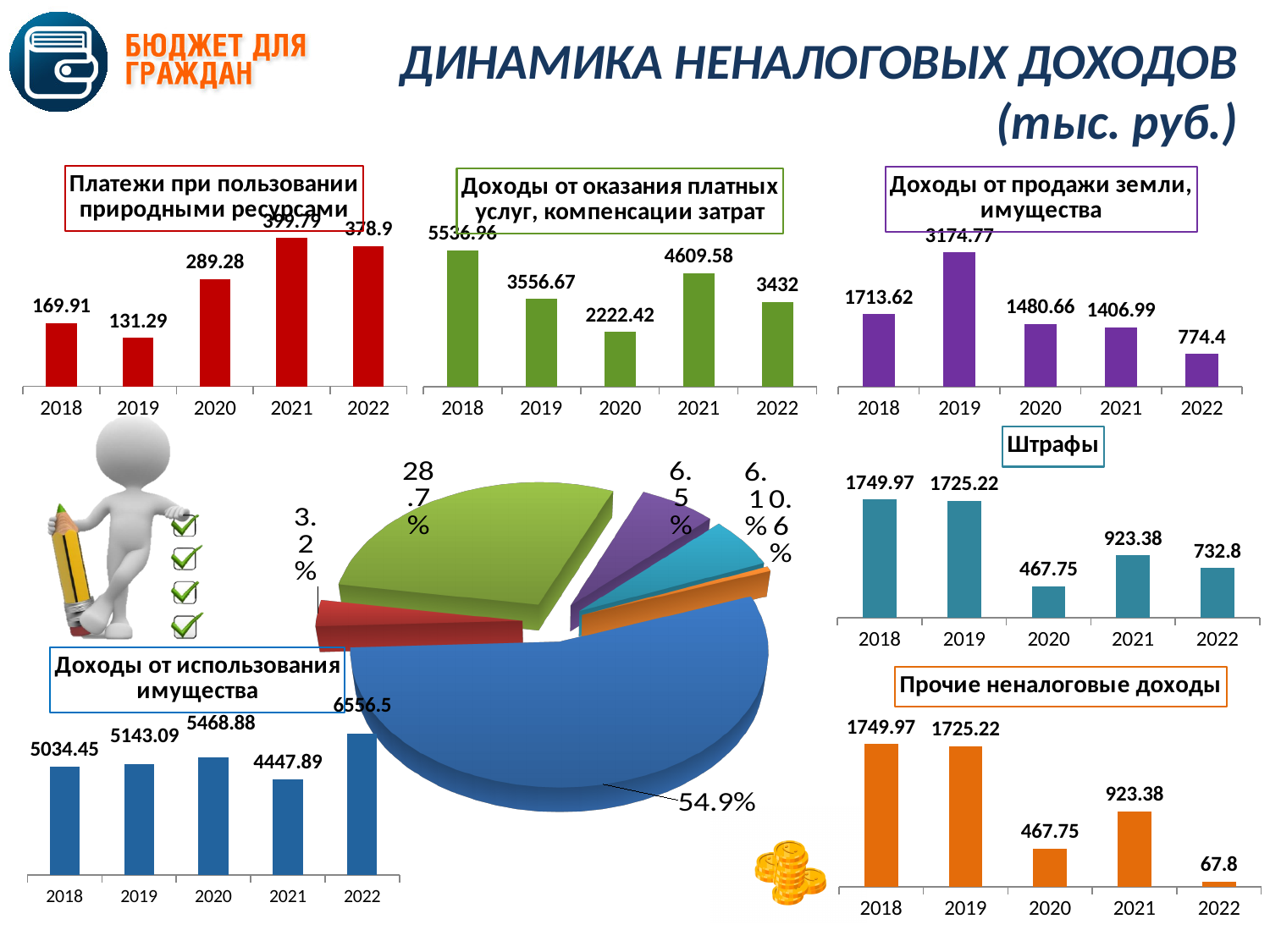
In the 'Доходы от оказания платных услуг, компенсации затрат' chart, what is the difference between the 2021 and 2022 values? 1177.58 In the 'Штрафы' chart, what is the value for 2020? 467.75 In the pie chart in the centre of the slide, what is the share of the largest slice? 54.9% What type of chart is 'Доходы от использования имущества'? Bar chart In the 'Доходы от продажи земли, имущества' chart, do the values rise or fall from 2019 to 2022? Fall In the 'Прочие неналоговые доходы' chart, what is the value for 2022? 67.8 How many years are shown on the x axis of the 'Штрафы' chart? 5 What colour are the bars in the 'Прочие неналоговые доходы' chart? Orange In the 'Доходы от продажи земли, имущества' chart, which is larger: the value for 2020 or the value for 2021? 2020 In the 'Доходы от использования имущества' chart, which year has the highest value? 2022 In the 'Платежи при пользовании природными ресурсами' chart, which year has the lowest value? 2019 In the 'Доходы от продажи земли, имущества' chart, what is the value for 2019? 3174.77